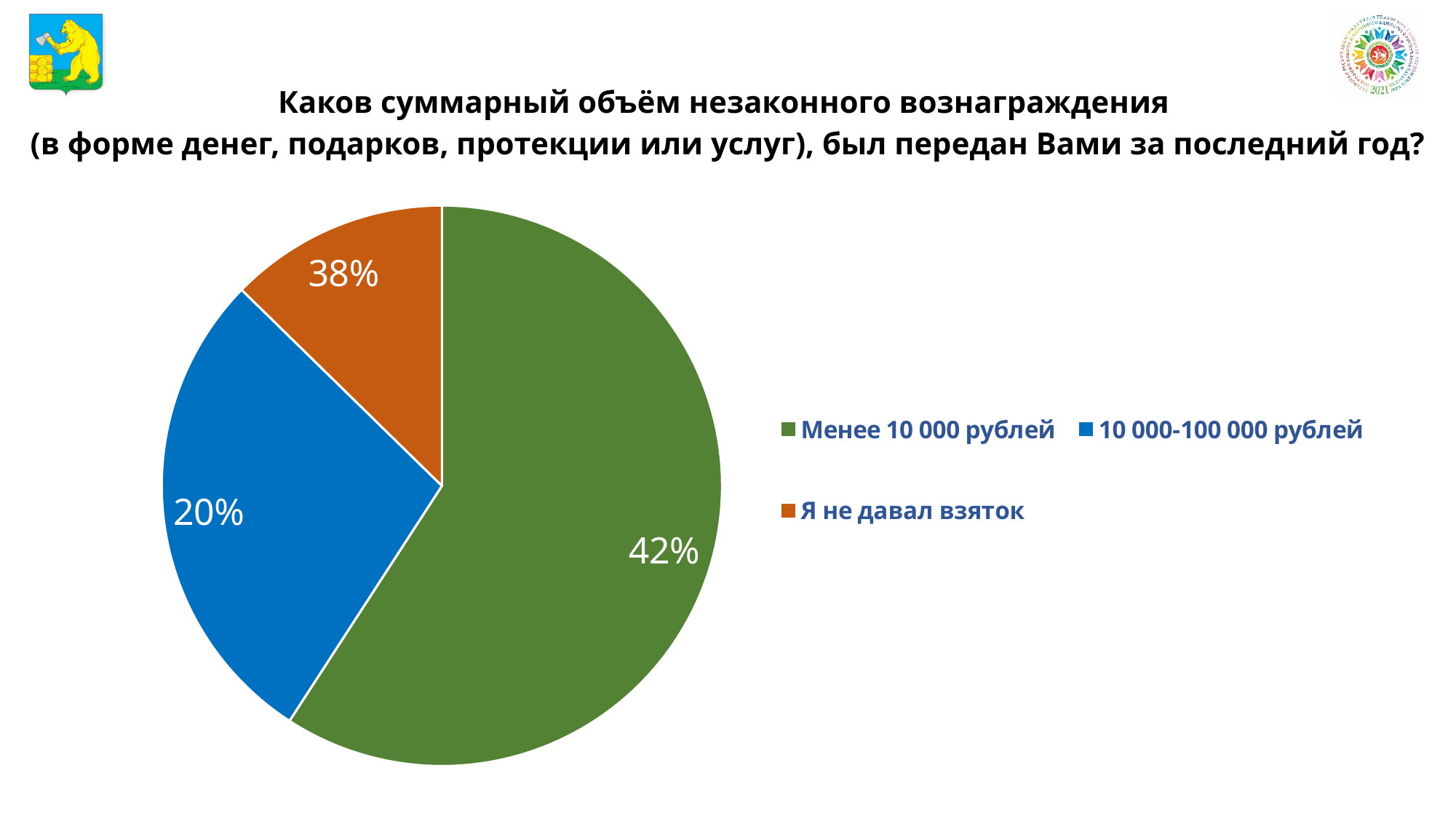
What type of chart is shown on the slide? pie chart What percentage is shown for the slice "10 000-100 000 рублей"? 20% What colour is the slice for "10 000-100 000 рублей"? blue How many entries does the legend list? 3 Which category has the largest share of the pie? Менее 10 000 рублей Which is larger: the share for "Менее 10 000 рублей" or the share for "10 000-100 000 рублей"? Менее 10 000 рублей What percentage is shown for the slice "Я не давал взяток"? 38% How many slices does the pie chart have? 3 What percentage is shown for the slice "Менее 10 000 рублей"? 42% What colour is the slice for "Я не давал взяток"? orange What is the difference in percentage points between the "Менее 10 000 рублей" slice and the "10 000-100 000 рублей" slice? 22